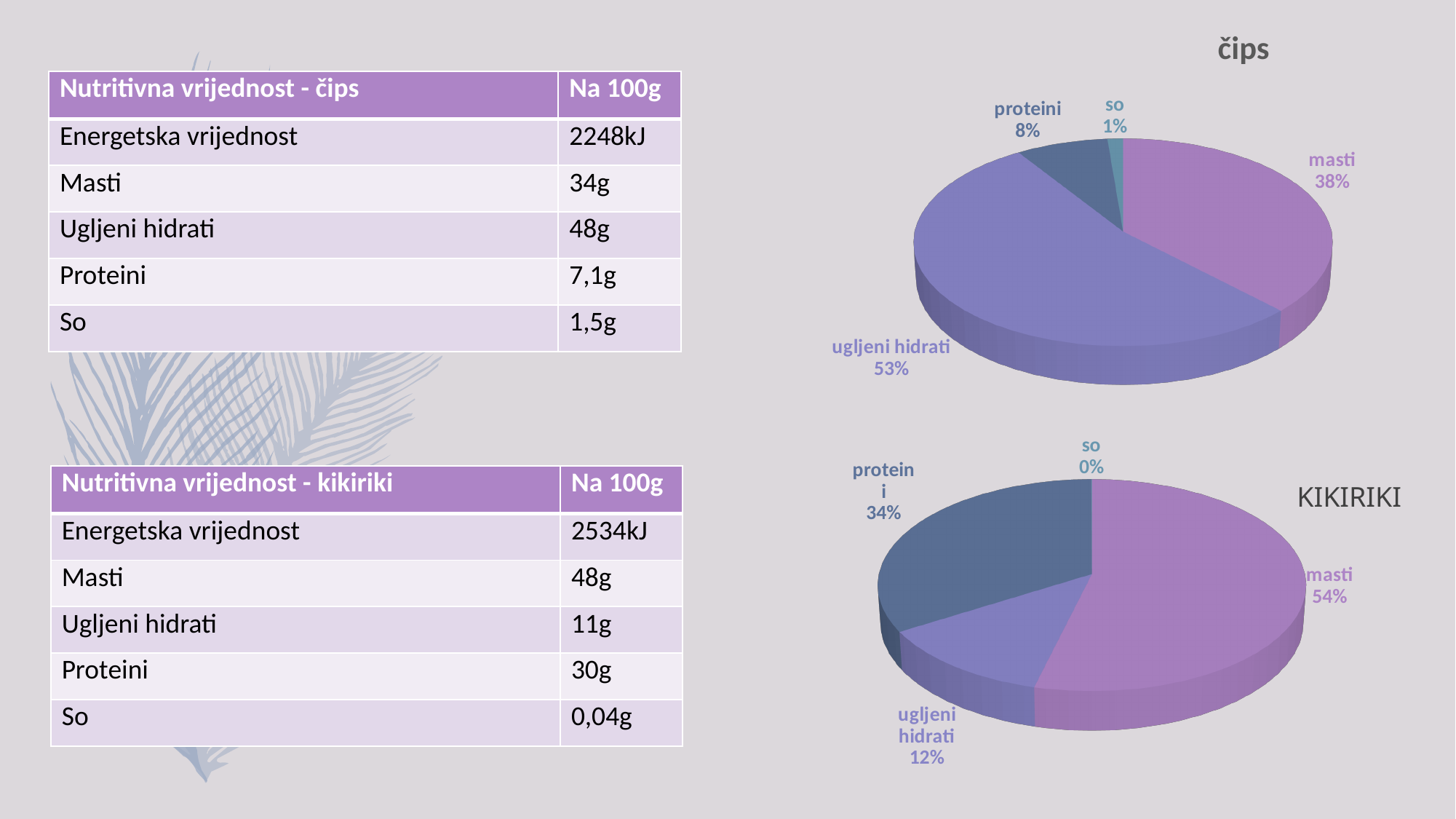
How many categories are shown in the 'čips' pie chart? 4 In the 'KIKIRIKI' pie chart, which category has the largest slice? masti In the 'KIKIRIKI' pie chart, which is larger, 'proteini' or 'ugljeni hidrati'? proteini In the 'čips' pie chart, which category has the smallest slice? so In the 'čips' pie chart, what share does 'masti' have? 38% In the 'čips' pie chart, what is the difference in percentage points between 'ugljeni hidrati' and 'masti'? 15 In the 'KIKIRIKI' pie chart, what share does 'proteini' have? 34% In the 'KIKIRIKI' pie chart, what share does 'masti' have? 54% In the 'čips' pie chart, which category has the largest slice? ugljeni hidrati In the 'KIKIRIKI' pie chart, what is the difference in percentage points between 'masti' and 'ugljeni hidrati'? 42 What type of chart is the 'KIKIRIKI' chart? pie chart